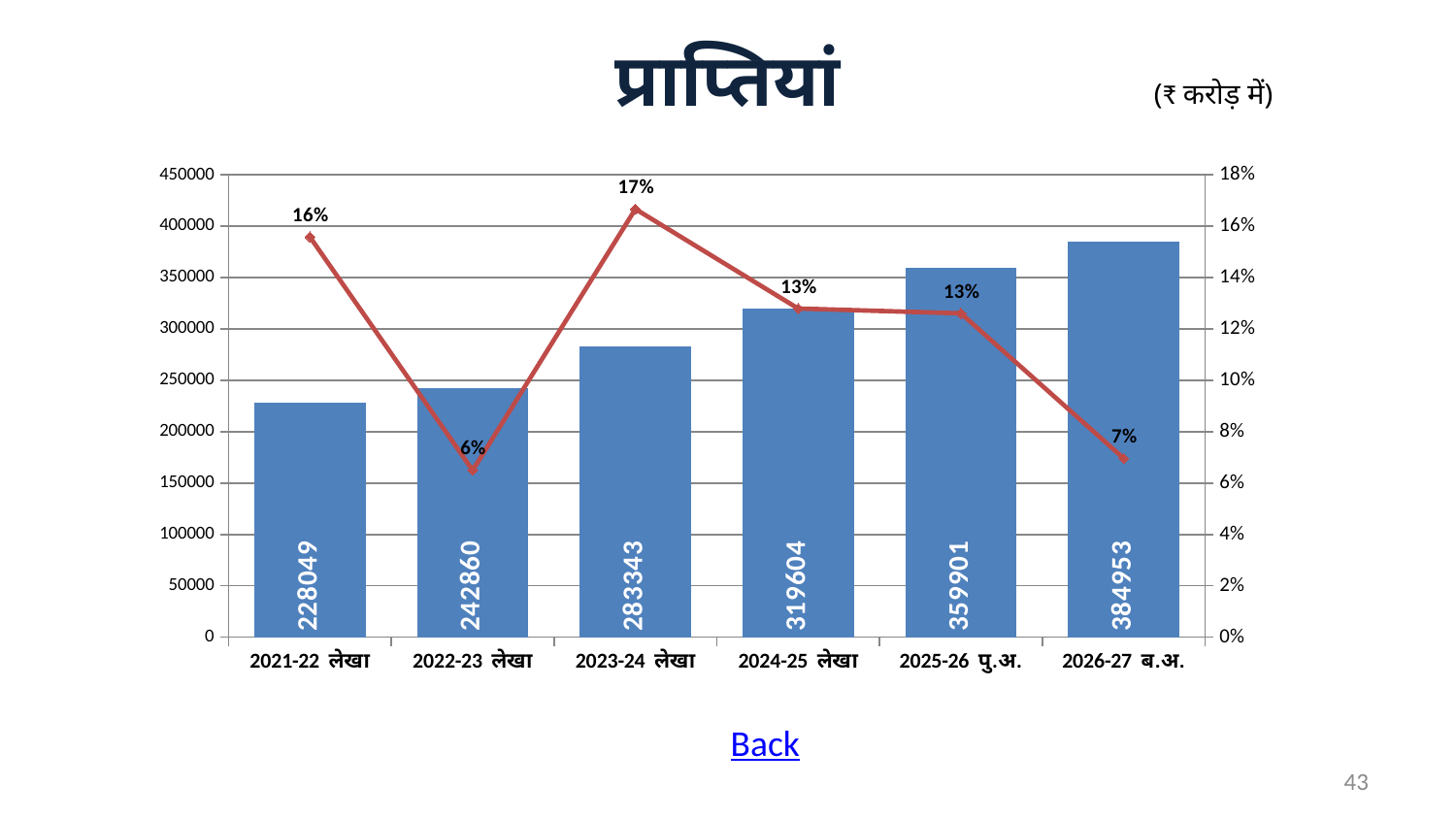
What is the title of the chart? प्राप्तियां What kind of chart is this? Combined bar and line chart Which category has the highest bar value? 2026-27 ब.अ. What percentage is shown on the line for 2022-23 लेखा? 6% What is the difference between the bar values for 2025-26 पु.अ. and 2024-25 लेखा? 40297 What is the bar value for 2026-27 ब.अ.? 384953 How many categories are shown on the x axis? 6 Do the bar values rise or fall from 2021-22 लेखा to 2026-27 ब.अ.? Rise What percentage is shown on the line for 2023-24 लेखा? 17% Which category has the lowest percentage on the line? 2022-23 लेखा Which is larger, the bar value for 2022-23 लेखा or for 2023-24 लेखा? 2023-24 लेखा What is the bar value for 2024-25 लेखा? 319604